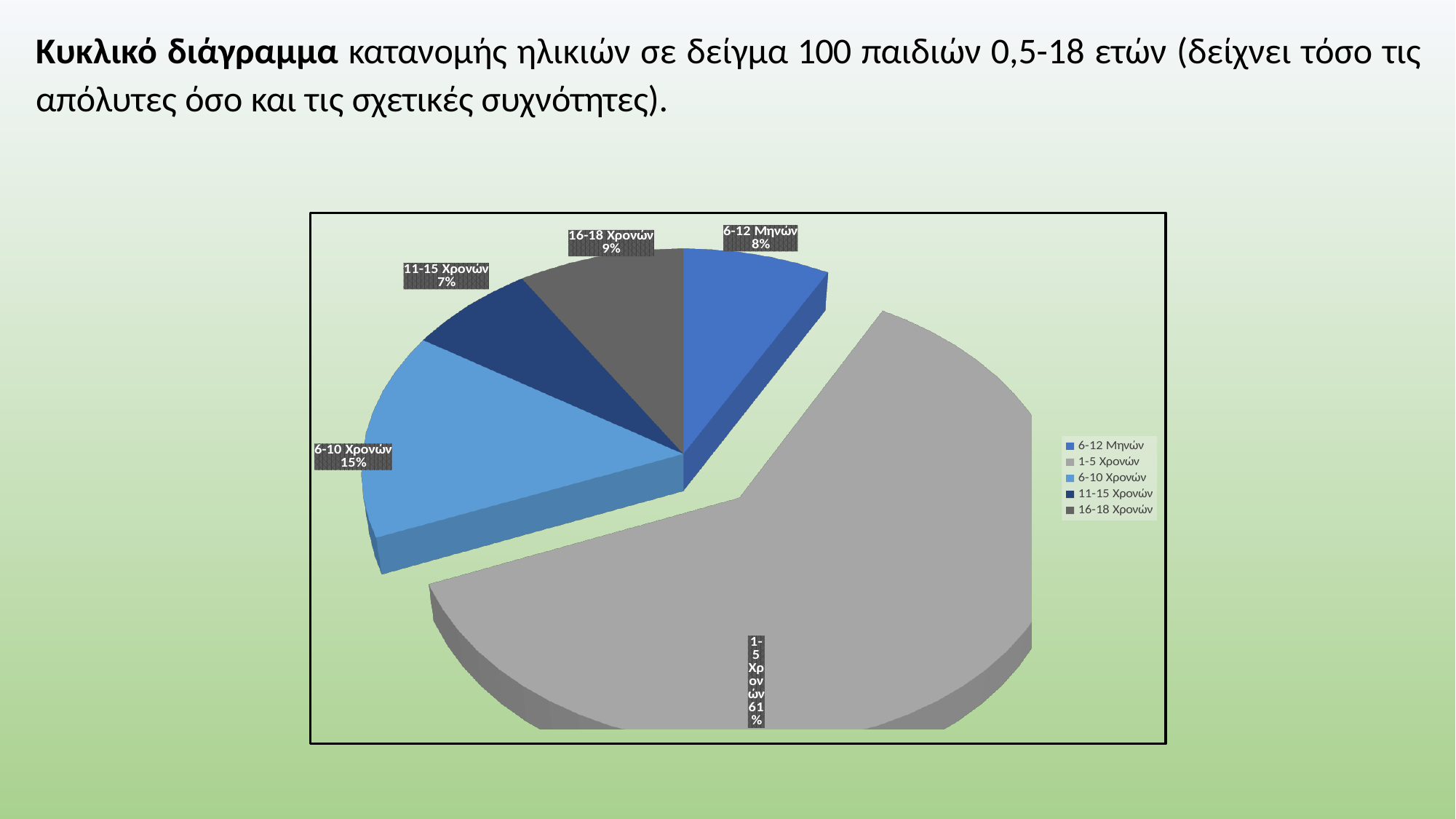
Which slice is larger, 6-12 Μηνών or 16-18 Χρονών? 16-18 Χρονών What is the difference in percentage points between the 6-10 Χρονών and 16-18 Χρονών slices? 6 Which age group has the largest share of the pie? 1-5 Χρονών Which age group has the smallest share of the pie? 11-15 Χρονών What kind of chart is shown on the slide? pie chart What percentage of the sample is in the 6-12 Μηνών age group? 8% How many entries does the legend list? 5 How many slices does the pie chart have? 5 What percentage of the sample is in the 11-15 Χρονών age group? 7% What percentage of the sample is in the 16-18 Χρονών age group? 9% What percentage of the sample is in the 1-5 Χρονών age group? 61% What percentage of the sample is in the 6-10 Χρονών age group? 15%